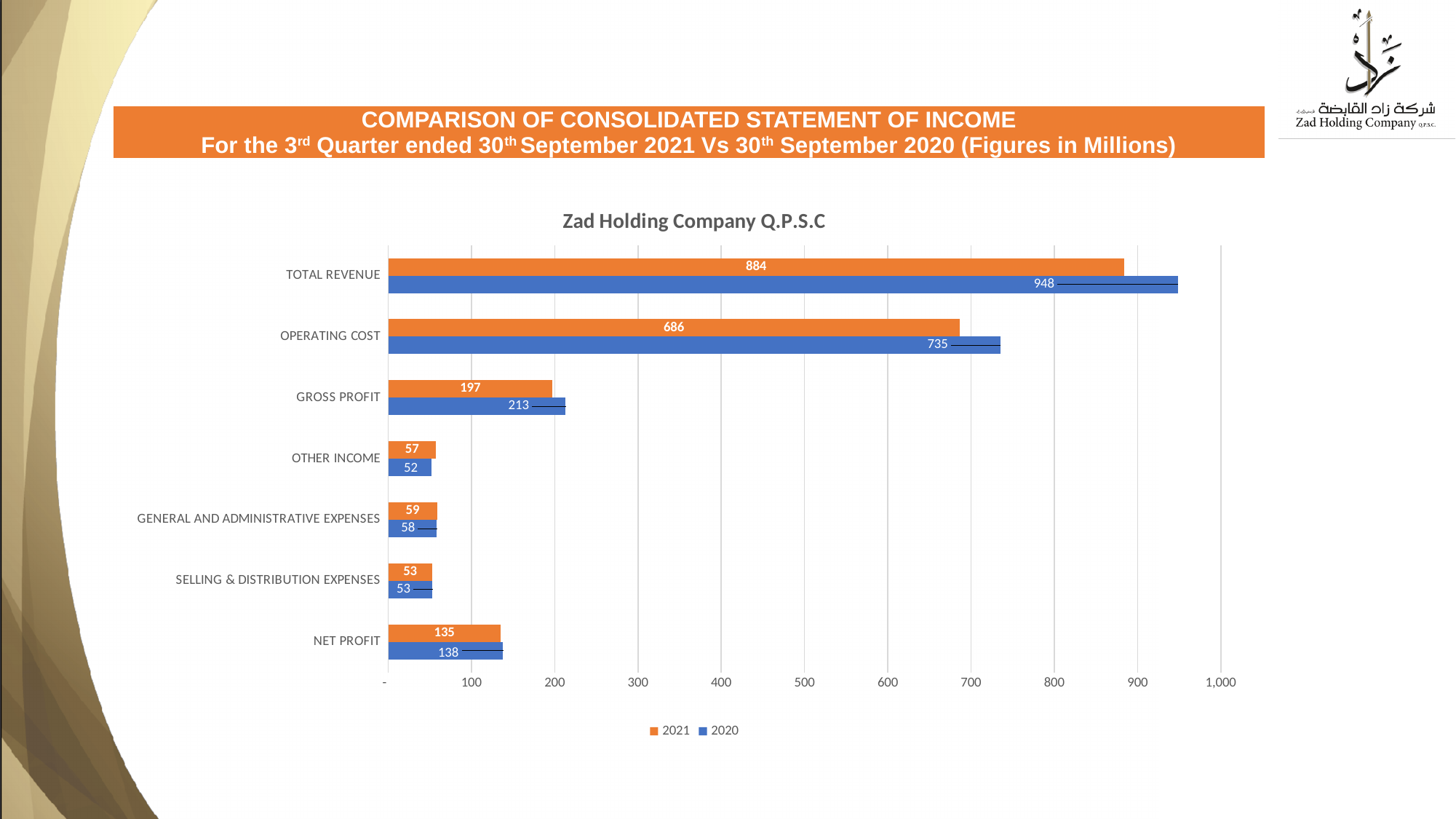
What is the difference between the 2020 and 2021 values for OPERATING COST? 49 Which is larger for OTHER INCOME, the 2021 value or the 2020 value? 2021 What kind of chart is shown on the slide? Bar chart What is the 2021 value for NET PROFIT? 135 What is the 2021 value for TOTAL REVENUE? 884 What is the 2020 value for OPERATING COST? 735 Which category has the lowest 2020 value? OTHER INCOME What is the 2020 value for GROSS PROFIT? 213 How many categories are shown on the chart? 7 How many series does the legend list? 2 What is the difference between the 2020 and 2021 values for TOTAL REVENUE? 64 Which category has the highest 2020 value? TOTAL REVENUE